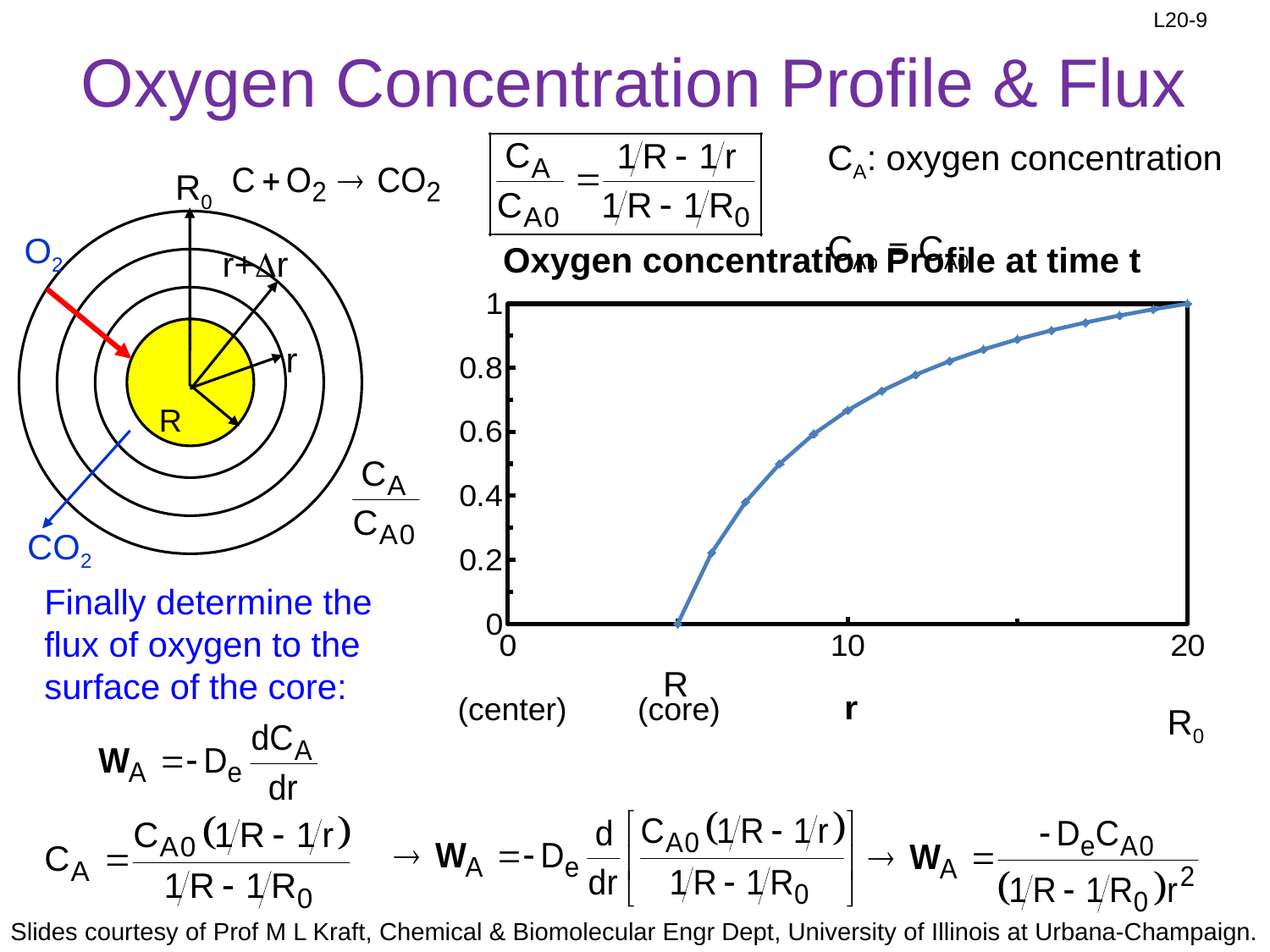
What is the title of the chart? Oxygen concentration Profile at time t Which is larger, CA/CA0 at r = 10 or at r = 15? r = 15 At which value of r is CA/CA0 highest? 20 What is the label on the x axis of the chart? r What kind of chart is shown on the slide? line chart At which value of r is CA/CA0 lowest? 5 What is the value of CA/CA0 at the core surface R (r = 5)? 0 What is the value of CA/CA0 at R0 (r = 20)? 1 Does CA/CA0 rise or fall as r increases from R to R0? rise Is the value of CA/CA0 at r = 15 greater or less than 0.8? greater Is the value of CA/CA0 at r = 10 greater or less than 0.8? less Is the value of CA/CA0 at r = 10 greater or less than 0.6? greater